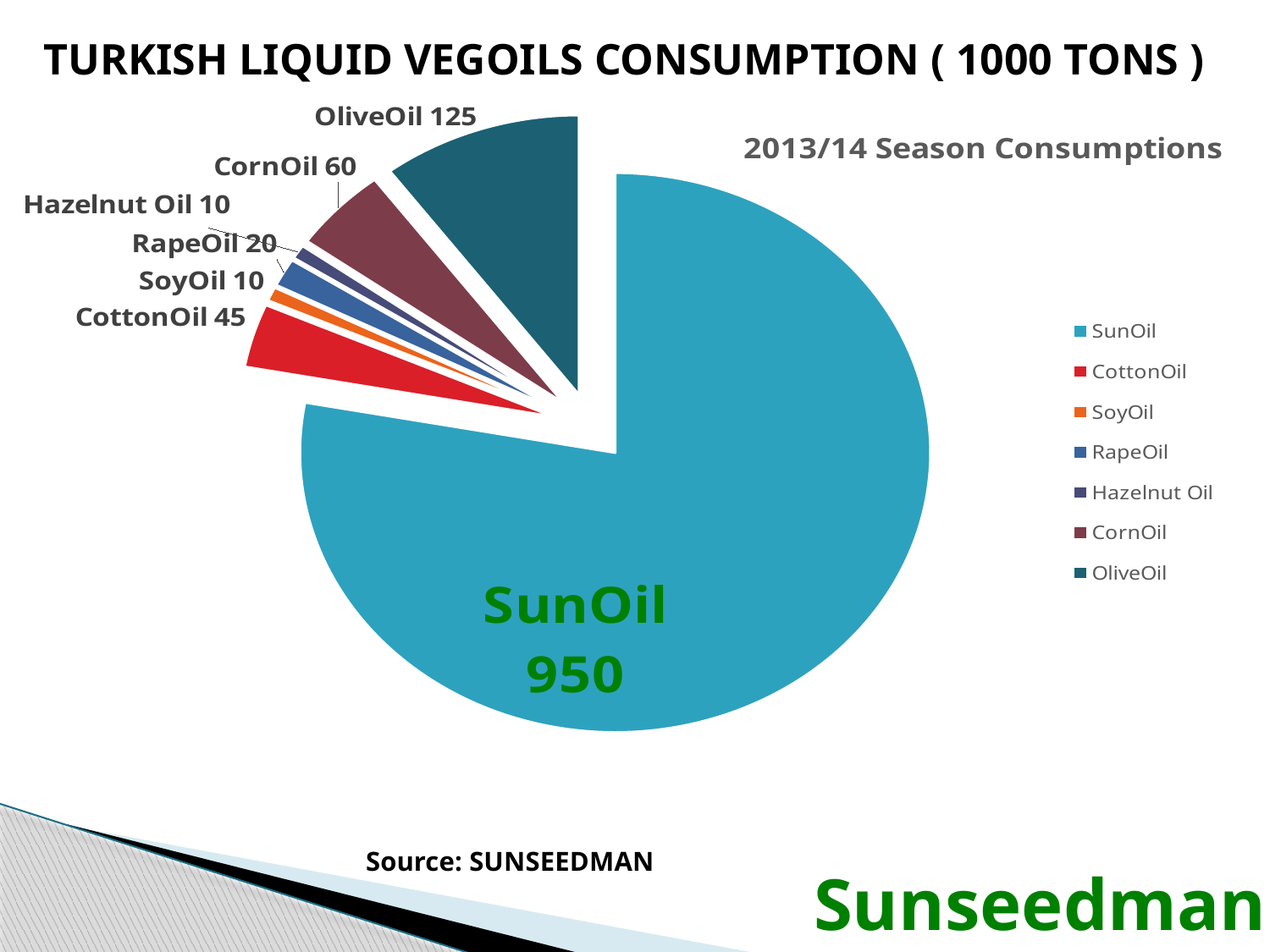
How many oil categories are shown in the pie chart? 7 What is the title of the chart on the slide? TURKISH LIQUID VEGOILS CONSUMPTION ( 1000 TONS ) What is the difference between the consumption of SunOil and OliveOil? 825 Which has a larger consumption, CottonOil or CornOil? CornOil Which oil has the largest consumption in the pie chart? SunOil What is the consumption value for CornOil? 60 What is the consumption value for RapeOil? 20 What type of chart is shown on the slide? Pie chart What is the consumption value for OliveOil? 125 What is the consumption value for SunOil in the pie chart? 950 What is the consumption value for CottonOil? 45 What is the difference between the consumption of OliveOil and CornOil? 65